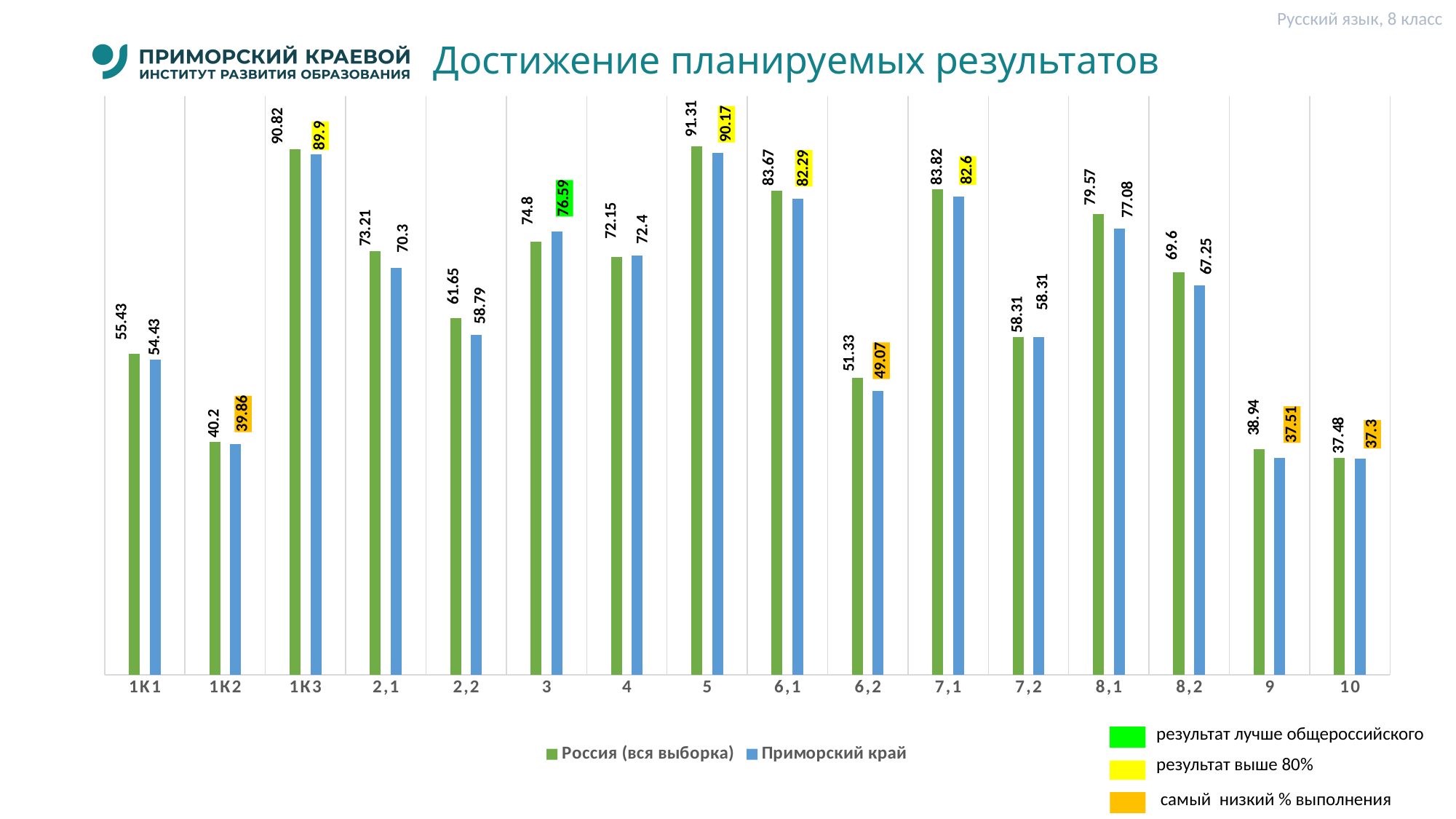
Which category has the highest value for Россия (вся выборка)? 5 How many categories are shown on the x axis? 16 What is the difference between the Россия (вся выборка) and Приморский край values for category 8,1? 2.49 What kind of chart is shown on the slide? Bar chart What is the value for Приморский край for category 1К3? 89.9 How many series does the legend list? 2 For category 4, which series has the larger value, Россия (вся выборка) or Приморский край? Приморский край What is the value for Приморский край for category 3? 76.59 What is the value for Россия (вся выборка) for category 7,2? 58.31 What is the title of the chart? Достижение планируемых результатов What is the value for Россия (вся выборка) for category 6,2? 51.33 Which category has the lowest value for Приморский край? 10